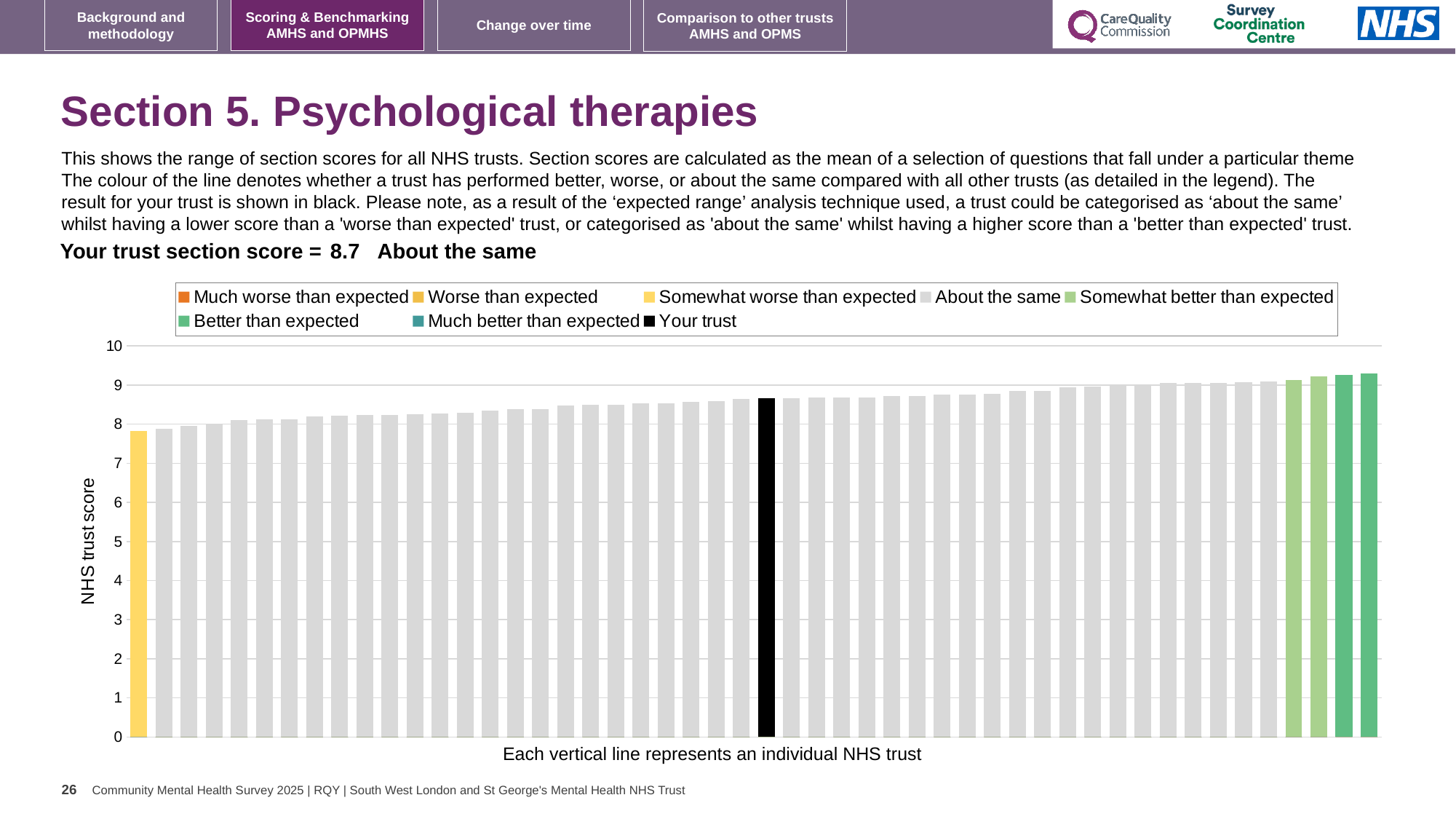
Is the value for the black 'Your trust' bar greater or less than 8? greater What is the section score for your trust shown on the slide? 8.7 Do the bar values rise or fall from left to right along the x axis? Rise Is the value for the tallest bar on the right greater or less than 9? greater How many bars are coloured yellow (Somewhat worse than expected)? 1 What kind of chart is shown on the slide? Bar chart What colour is the bar representing your trust? Black How many entries does the chart legend list? 8 What is the label on the vertical axis of the chart? NHS trust score How many bars are coloured green (Somewhat better or Better than expected)? 4 Is the value for the leftmost bar greater or less than 9? less Which category is your trust placed in for this section? About the same